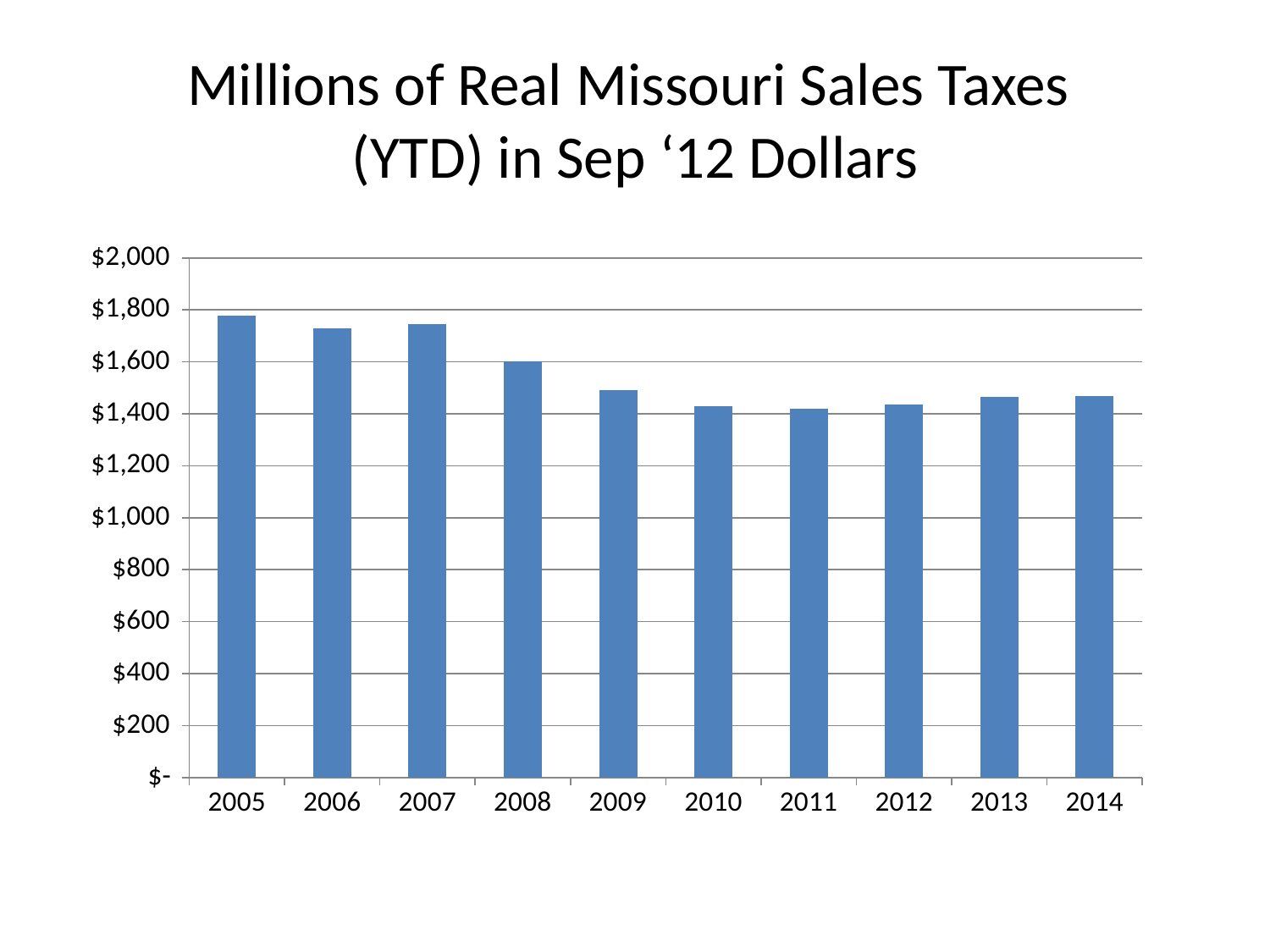
Do the values rise or fall from 2005 to 2008? fall What kind of chart is shown on the slide? bar chart What is the title of the chart? Millions of Real Missouri Sales Taxes (YTD) in Sep '12 Dollars Is the value for 2005 greater or less than $1,600? greater Is the value for 2008 greater or less than $1,800? less Which is larger, the value for 2008 or the value for 2009? 2008 Which is larger, the value for 2005 or the value for 2010? 2005 Is the value for 2009 greater or less than $1,400? greater Which year has the highest value on the chart? 2005 How many years are plotted on the chart? 10